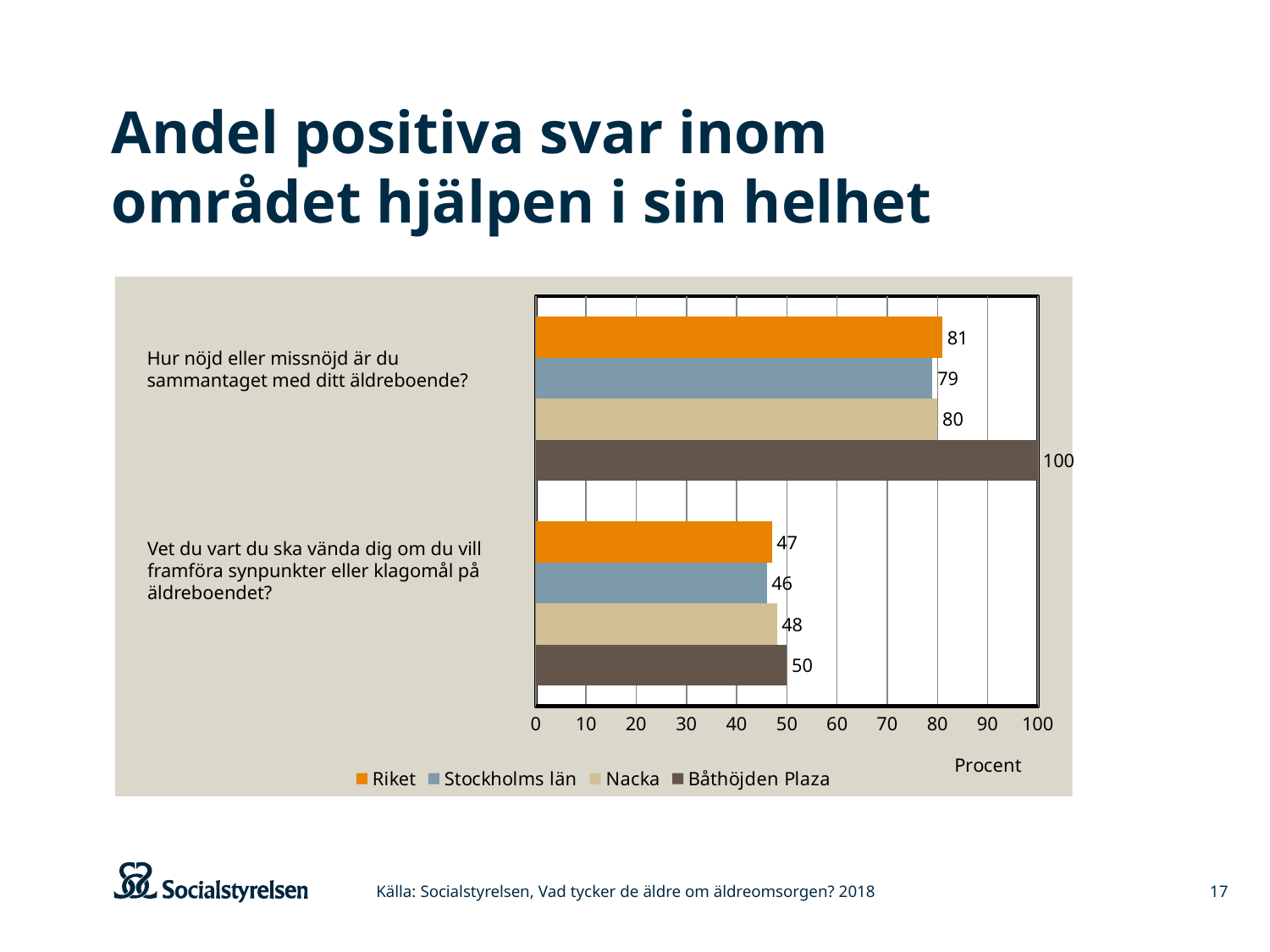
Which series has the highest value on the question "Hur nöjd eller missnöjd är du sammantaget med ditt äldreboende?"? Båthöjden Plaza What is the label on the horizontal axis of the chart? Procent What is the value for Riket on the question "Vet du vart du ska vända dig om du vill framföra synpunkter eller klagomål på äldreboendet?"? 47 Which series has the lowest value on the question "Vet du vart du ska vända dig om du vill framföra synpunkter eller klagomål på äldreboendet?"? Stockholms län What is the value for Båthöjden Plaza on the question "Hur nöjd eller missnöjd är du sammantaget med ditt äldreboende?"? 100 What kind of chart is shown on the slide? Bar chart What is the difference between the Båthöjden Plaza value and the Riket value on the question "Hur nöjd eller missnöjd är du sammantaget med ditt äldreboende?"? 19 Which is larger for Riket: the value for "Hur nöjd eller missnöjd är du sammantaget med ditt äldreboende?" or the value for "Vet du vart du ska vända dig om du vill framföra synpunkter eller klagomål på äldreboendet?"? Hur nöjd eller missnöjd är du sammantaget med ditt äldreboende? What is the difference between the Båthöjden Plaza value and the Stockholms län value on the question "Vet du vart du ska vända dig om du vill framföra synpunkter eller klagomål på äldreboendet?"? 4 How many series does the legend list? 4 What is the value for Nacka on the question "Vet du vart du ska vända dig om du vill framföra synpunkter eller klagomål på äldreboendet?"? 48 What is the value for Stockholms län on the question "Hur nöjd eller missnöjd är du sammantaget med ditt äldreboende?"? 79